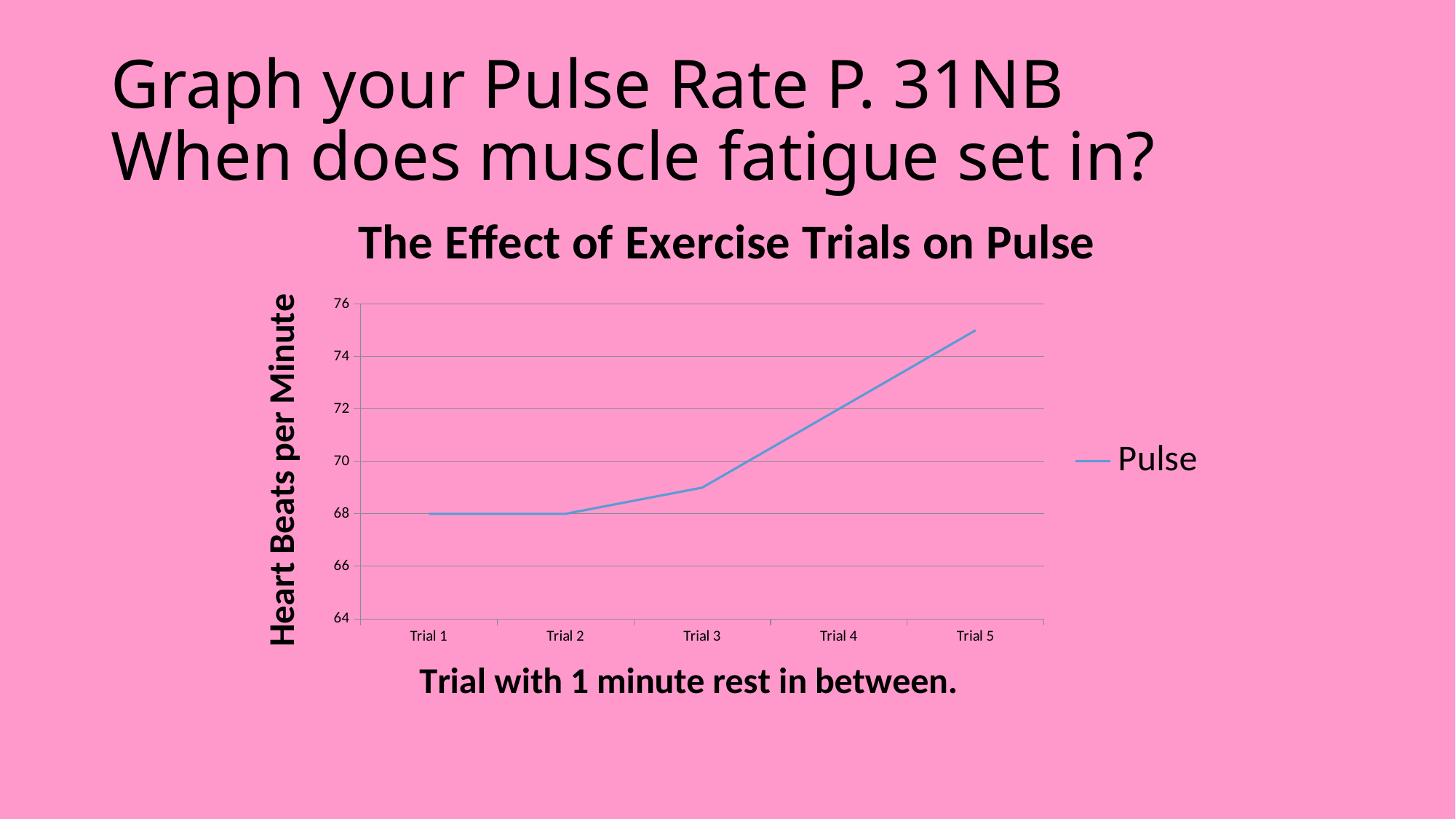
What is the title of the chart? The Effect of Exercise Trials on Pulse What is the pulse value for Trial 4? 72 Which trial has the highest pulse value? Trial 5 Do the pulse values rise or fall from Trial 1 to Trial 5? Rise What is the difference between the pulse values for Trial 4 and Trial 1? 4 What is the pulse value for Trial 1? 68 How many trials are plotted on the x axis? 5 What type of chart is shown on the slide? Line chart Is the value for Trial 3 greater or less than 70? less Is the value for Trial 5 greater or less than 74? greater What is the pulse value for Trial 2? 68 Which has a larger pulse value, Trial 4 or Trial 2? Trial 4